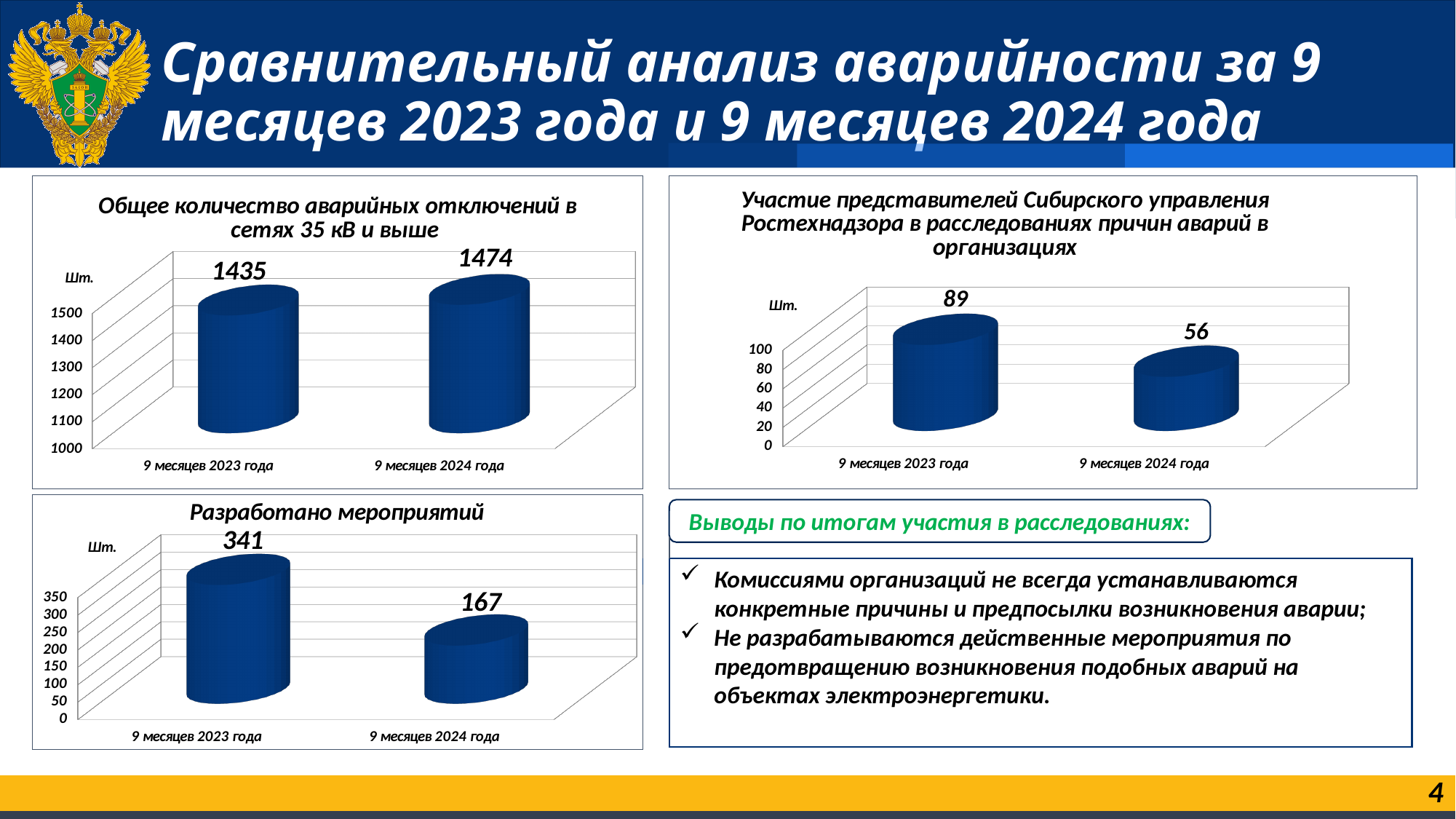
In the chart 'Общее количество аварийных отключений в сетях 35 кВ и выше', do the values rise or fall from 2023 to 2024? rise In the chart 'Общее количество аварийных отключений в сетях 35 кВ и выше', what is the value for 9 месяцев 2024 года? 1474 In the chart 'Разработано мероприятий', what is the value for 9 месяцев 2023 года? 341 In the chart 'Участие представителей Сибирского управления Ростехнадзора в расследованиях причин аварий в организациях', by how much does the 2023 value exceed the 2024 value? 33 In the chart 'Участие представителей Сибирского управления Ростехнадзора в расследованиях причин аварий в организациях', which period has the higher value? 9 месяцев 2023 года In the chart 'Участие представителей Сибирского управления Ростехнадзора в расследованиях причин аварий в организациях', what is the value for 9 месяцев 2024 года? 56 In the chart 'Общее количество аварийных отключений в сетях 35 кВ и выше', what is the difference between the 2024 and 2023 values? 39 In the chart 'Разработано мероприятий', what is the value for 9 месяцев 2024 года? 167 What kind of chart is 'Разработано мероприятий'? bar chart In the chart 'Участие представителей Сибирского управления Ростехнадзора в расследованиях причин аварий в организациях', what is the value for 9 месяцев 2023 года? 89 In the chart 'Общее количество аварийных отключений в сетях 35 кВ и выше', what is the value for 9 месяцев 2023 года? 1435 In the chart 'Разработано мероприятий', what is the difference between the 2023 and 2024 values? 174